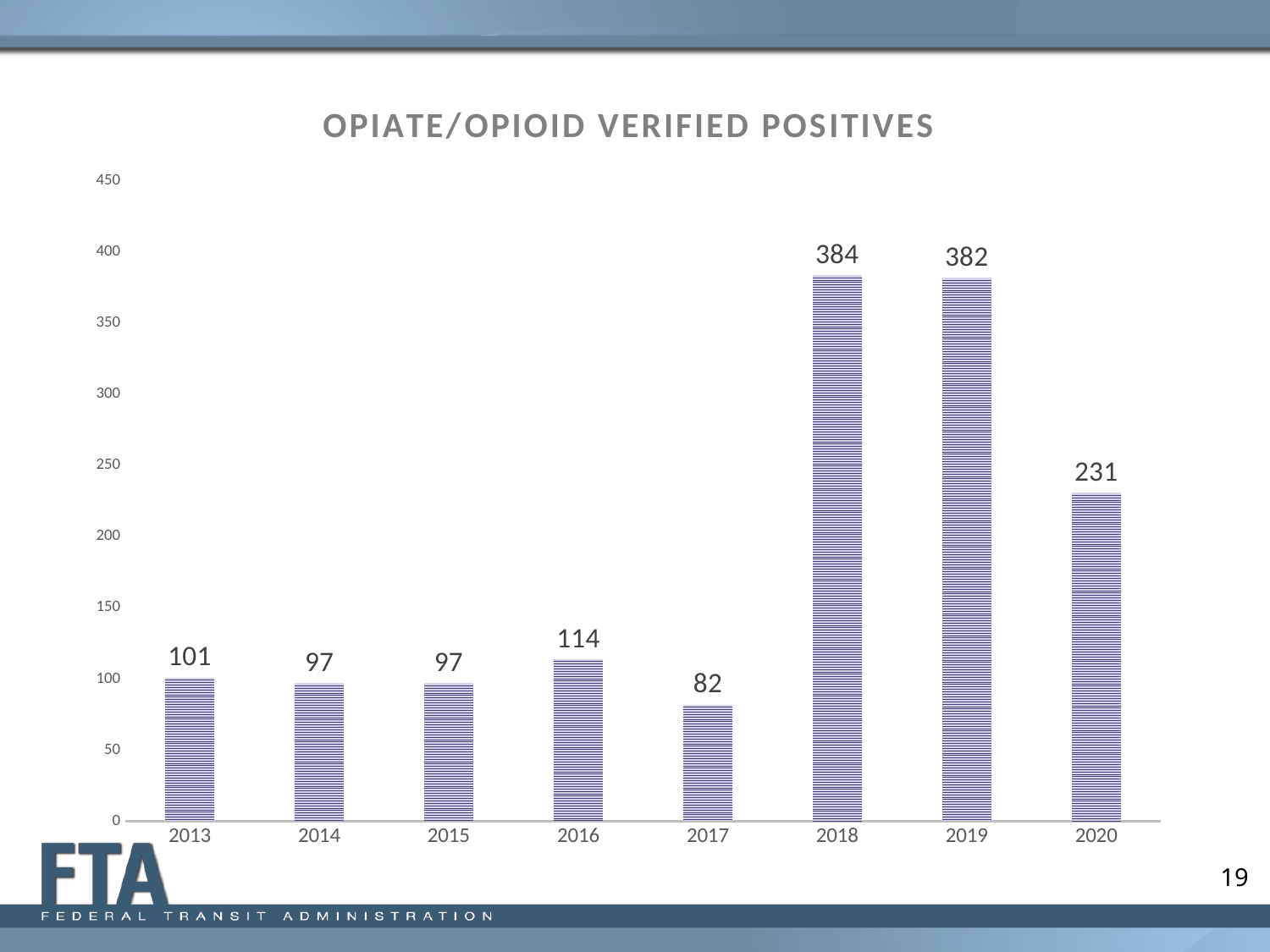
Which year has the lowest value? 2017 What is the value for 2018? 384 What is the title of the chart? OPIATE/OPIOID VERIFIED POSITIVES Is the value for 2020 greater or less than 200? greater Which is larger, the value for 2013 or the value for 2016? 2016 What is the value for 2017? 82 What is the value for 2020? 231 How many years are shown on the x axis? 8 What kind of chart is this? bar chart What is the difference between the values for 2016 and 2013? 13 What is the difference between the values for 2019 and 2020? 151 Which year has the highest value? 2018